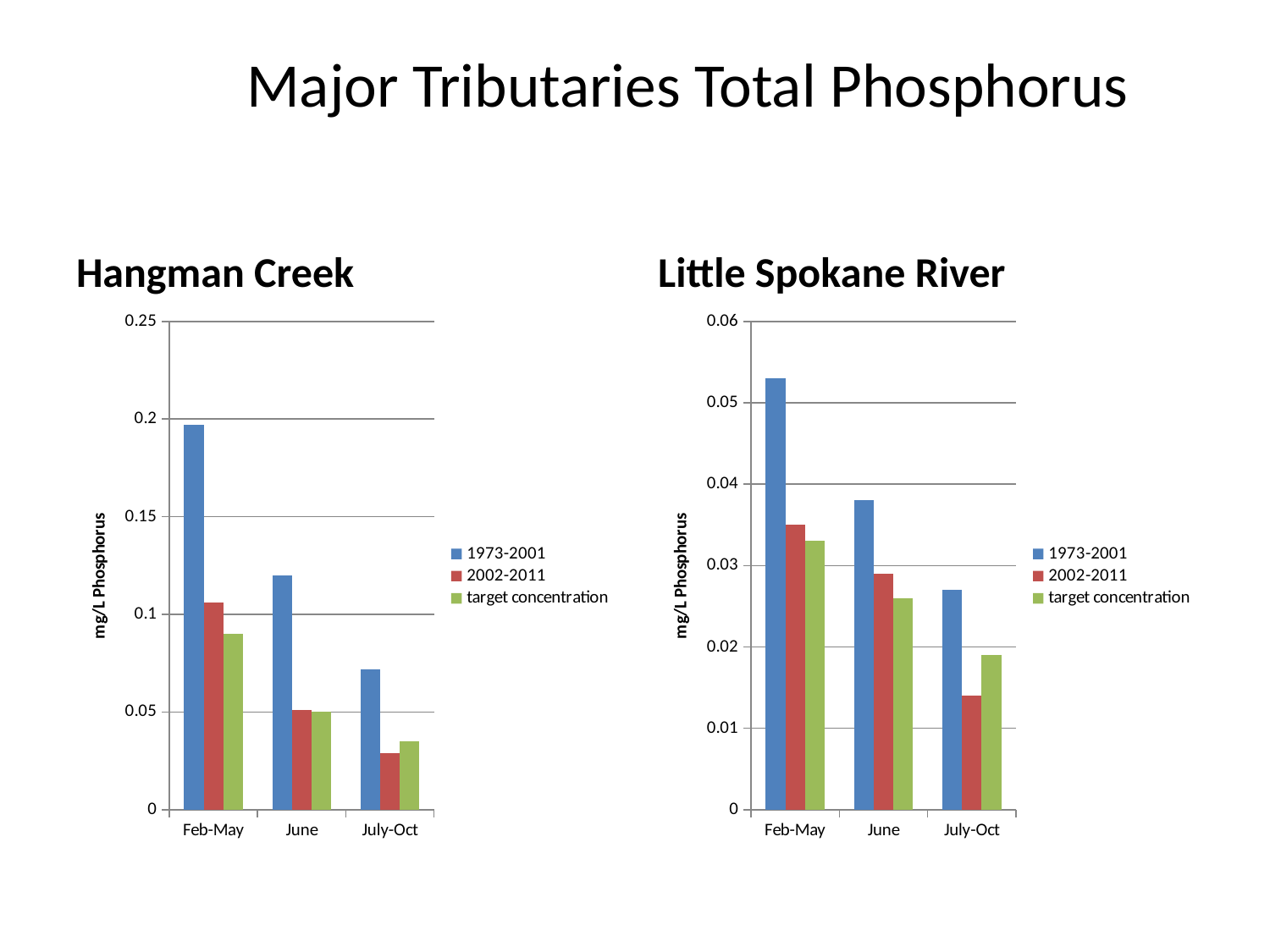
What kind of chart is the Hangman Creek chart? bar chart In the Little Spokane River chart, is the 1973-2001 value for Feb-May greater or less than 0.05? greater In the Hangman Creek chart, do the 1973-2001 values rise or fall from Feb-May to July-Oct? fall How many periods are shown on the x axis of the Hangman Creek chart? 3 What is the y-axis label on the Little Spokane River chart? mg/L Phosphorus In the Hangman Creek chart, is the 2002-2011 value for July-Oct greater or less than 0.05? less In the Little Spokane River chart, for Feb-May, which is larger: the 1973-2001 value or the 2002-2011 value? 1973-2001 In the Hangman Creek chart, is the 1973-2001 value for Feb-May greater or less than 0.15? greater In the Little Spokane River chart, which period has the lowest 2002-2011 value? July-Oct How many series does the legend of the Little Spokane River chart list? 3 In the Hangman Creek chart, which period has the highest 1973-2001 value? Feb-May